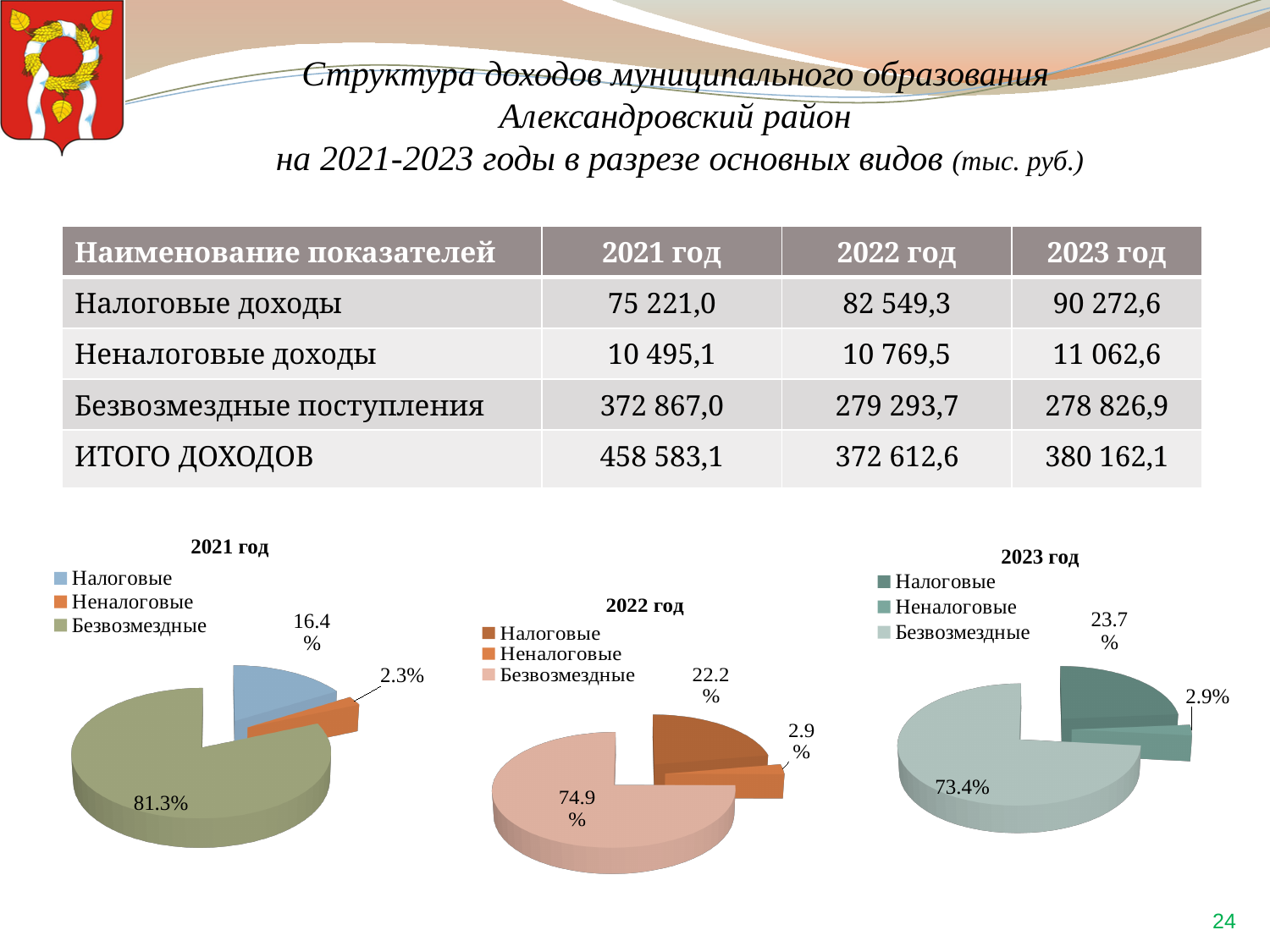
In the "2021 год" pie chart, what share is shown for Безвозмездные? 81.3% In the "2023 год" pie chart, what share is shown for Безвозмездные? 73.4% In the "2022 год" pie chart, what share is shown for Неналоговые? 2.9% Is the Налоговые share larger in the "2022 год" pie chart or in the "2023 год" pie chart? 2023 год In the "2023 год" pie chart, what is the difference between the Налоговые share and the Неналоговые share? 20.8% How many slices does the "2022 год" pie chart have? 3 How many entries does the legend of the "2023 год" chart list? 3 In the "2021 год" pie chart, what share is shown for Налоговые? 16.4% In the "2022 год" pie chart, which category has the largest slice? Безвозмездные In the "2021 год" pie chart, which category has the smallest slice? Неналоговые What type of chart is used for "2021 год"? Pie chart In the "2023 год" pie chart, what share is shown for Налоговые? 23.7%